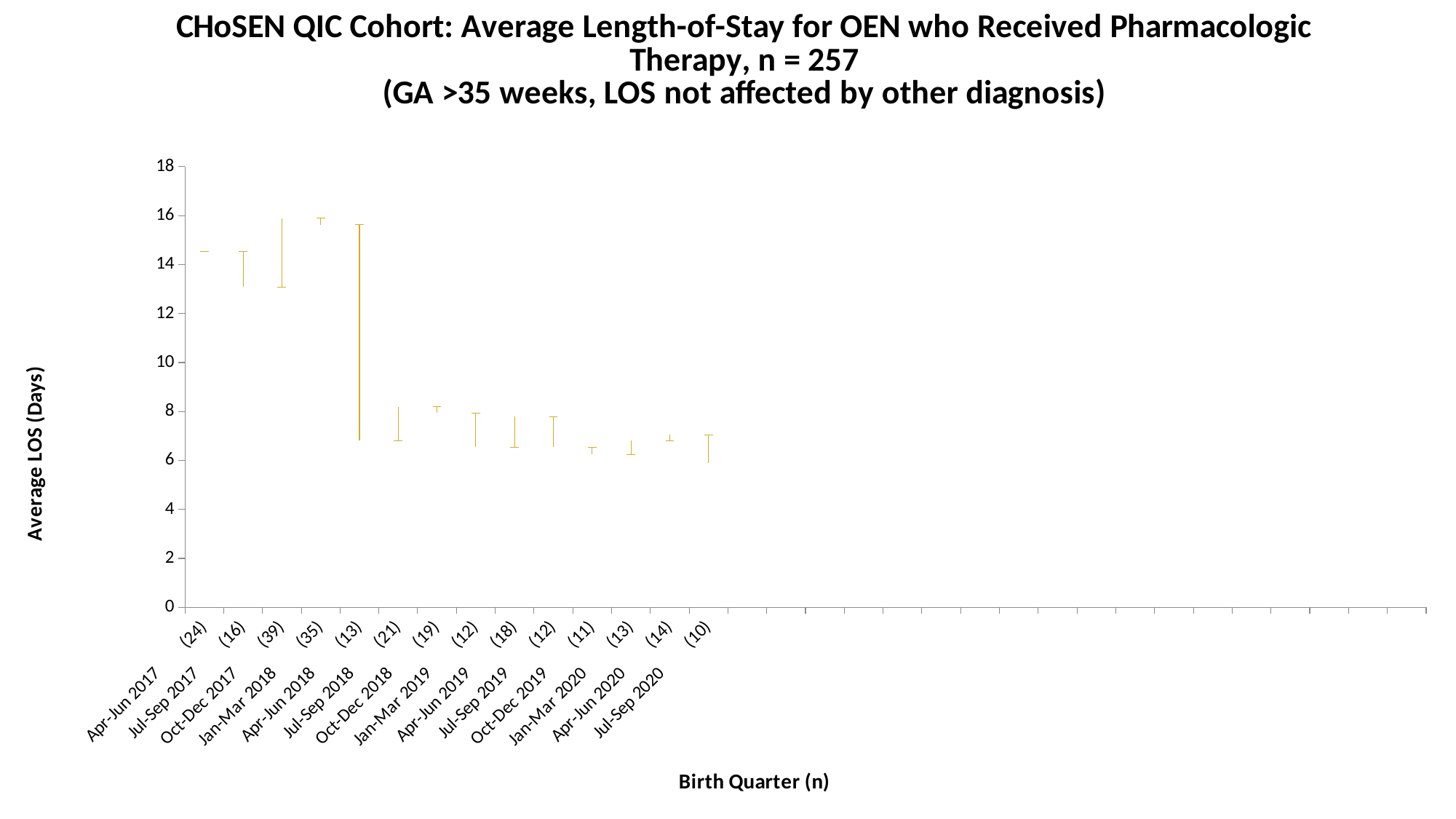
Is the average LOS for Apr-Jun 2017 greater or less than 12 days? greater Which birth quarter has the largest n in parentheses? Oct-Dec 2017 What is the n shown for the Jul-Sep 2020 birth quarter? 10 What is the n shown for the Oct-Dec 2017 birth quarter? 39 Is the average LOS for Jan-Mar 2018 greater or less than 10 days? greater Which birth quarter has the smallest n in parentheses? Jul-Sep 2020 What is the y-axis label of the chart? Average LOS (Days) What is the x-axis label of the chart? Birth Quarter (n) Which has a higher average LOS, Apr-Jun 2017 or Jul-Sep 2020? Apr-Jun 2017 Do the average LOS values generally rise or fall from Apr-Jun 2017 to Jul-Sep 2020? fall How many birth quarters are shown on the x axis of the chart? 14